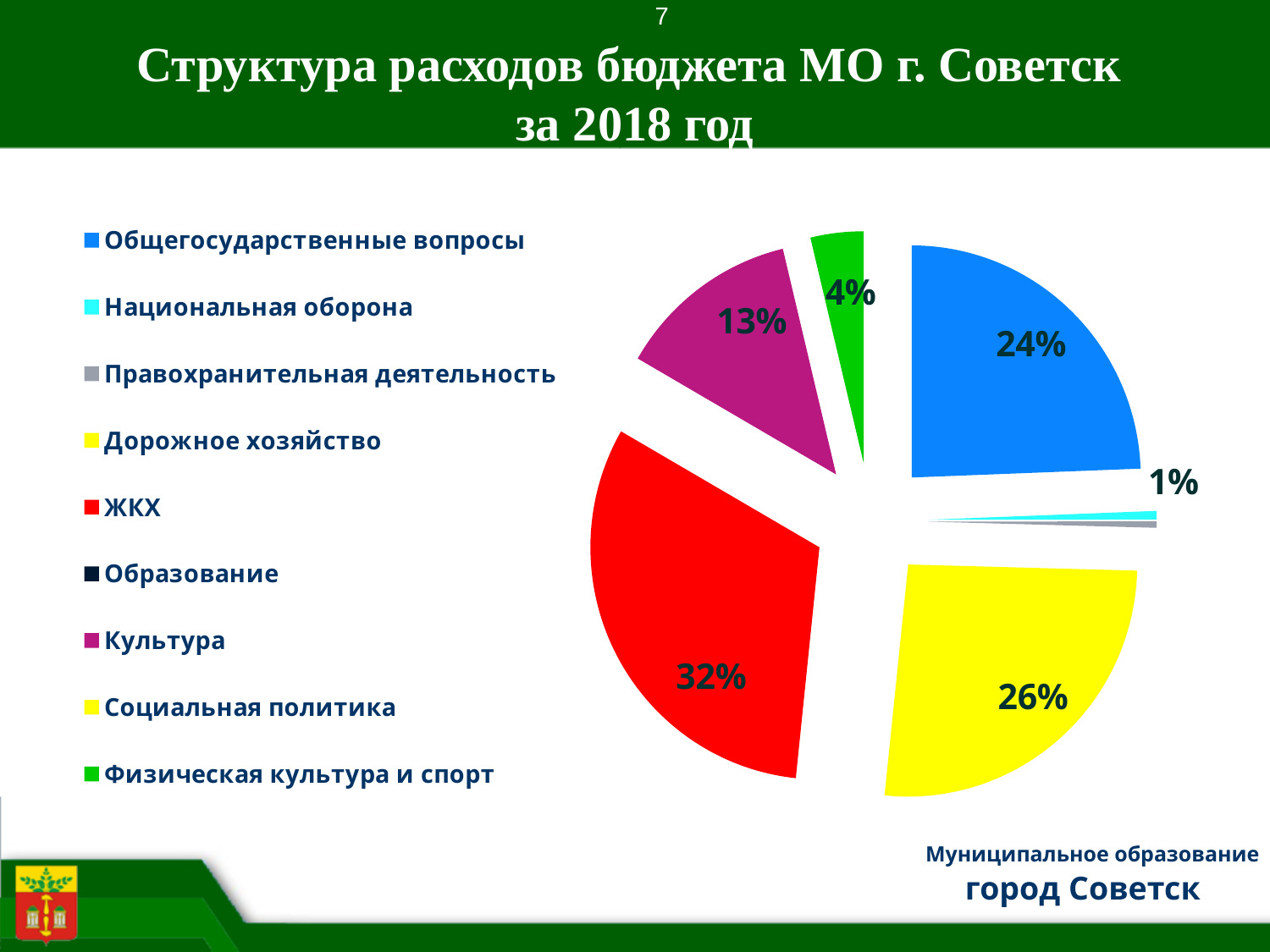
What share of the budget expenditure does Общегосударственные вопросы account for? 24% By how many percentage points does the share for Культура exceed the share for Физическая культура и спорт? 9 percentage points By how many percentage points does the share for ЖКХ exceed the share for Общегосударственные вопросы? 8 percentage points What share of the budget expenditure does Культура account for? 13% What kind of chart is shown on the slide? Pie chart Which is larger: the share for ЖКХ or the share for Общегосударственные вопросы? ЖКХ How many categories does the legend of the pie chart list? 9 Which category has the largest share of the pie? ЖКХ What share of the budget expenditure does Физическая культура и спорт account for? 4% What colour is the ЖКХ slice in the pie chart? Red What is the title of the slide containing the pie chart? Структура расходов бюджета МО г. Советск за 2018 год What share of the budget expenditure does ЖКХ account for? 32%